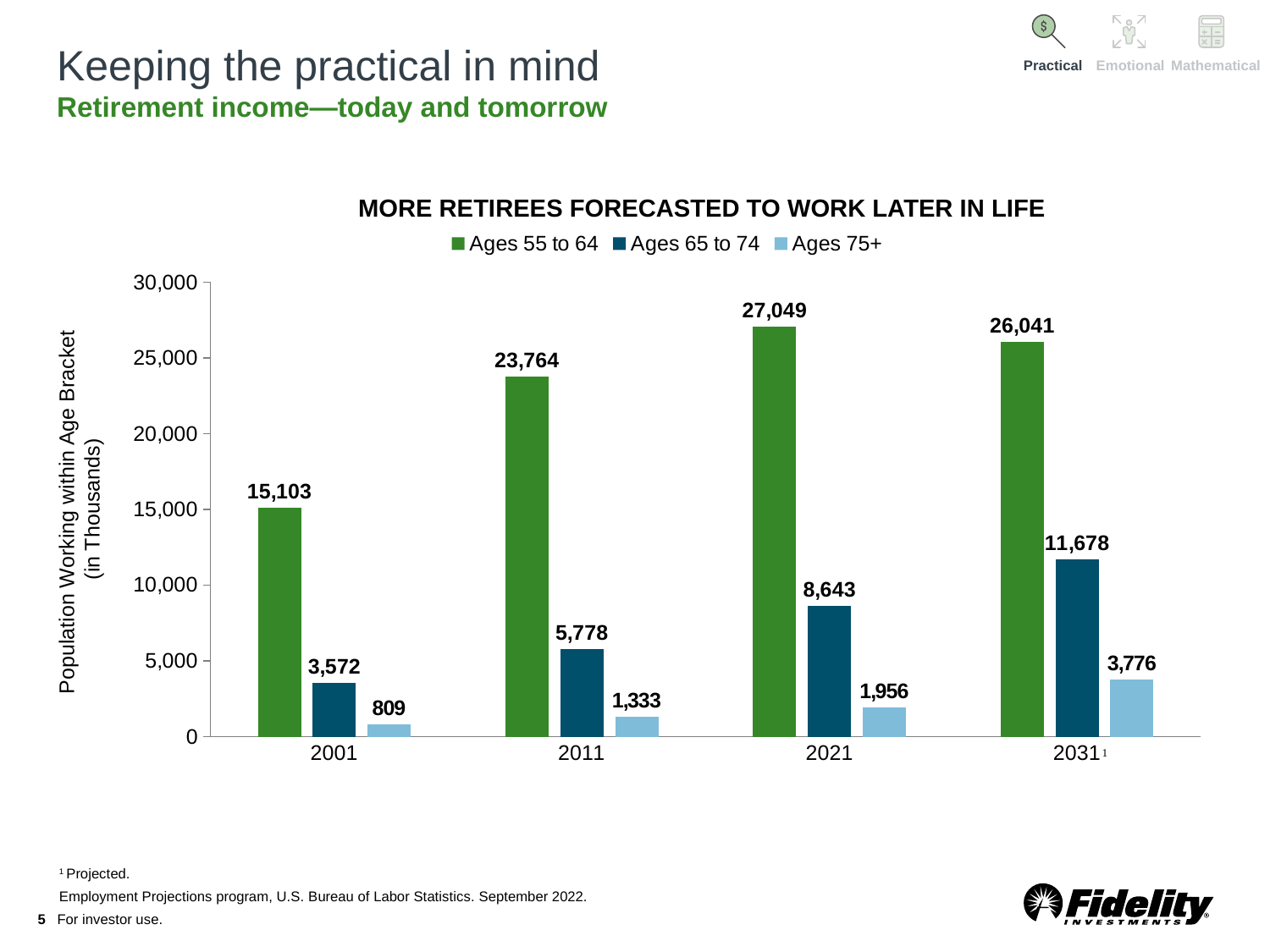
Which is larger: Ages 55 to 64 in 2011 or Ages 55 to 64 in 2031? Ages 55 to 64 in 2031 How many series does the legend list? 3 Does the Ages 65 to 74 series rise or fall from 2001 to 2031? Rise What is the value for Ages 55 to 64 in 2021? 27,049 In which year is the Ages 75+ value lowest? 2001 In which year is the Ages 55 to 64 value highest? 2021 What is the value for Ages 75+ in 2001? 809 What is the value for Ages 65 to 74 in 2031? 11,678 Is the value for Ages 65 to 74 in 2021 greater or less than 10,000? less What kind of chart is shown? Bar chart What is the difference between the Ages 65 to 74 values in 2031 and 2021? 3,035 How many years are shown on the x axis? 4